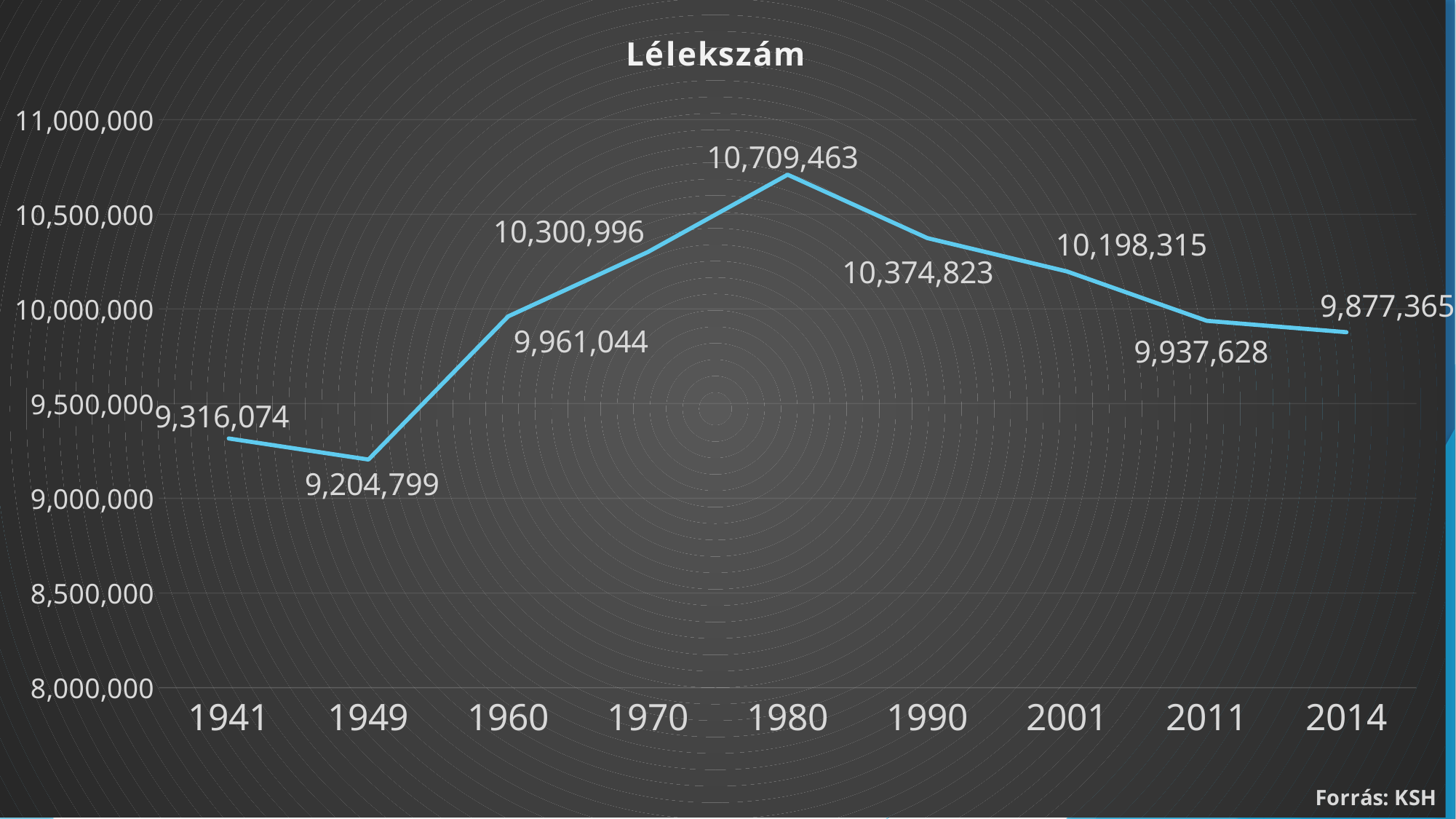
Which is larger, the value for 1990 or the value for 2001? 1990 How many data points are plotted on the chart? 9 What kind of chart is shown? line chart What is the difference between the values for 1980 and 1949? 1,504,664 What is the value for 2014? 9,877,365 What is the difference between the values for 2011 and 2014? 60,263 Is the value for 1970 greater or less than 10,000,000? greater Do the values rise or fall from 1980 to 2014? fall What is the value for 1949? 9,204,799 Which year has the lowest value? 1949 Which year has the highest value? 1980 What is the value for 1980? 10,709,463